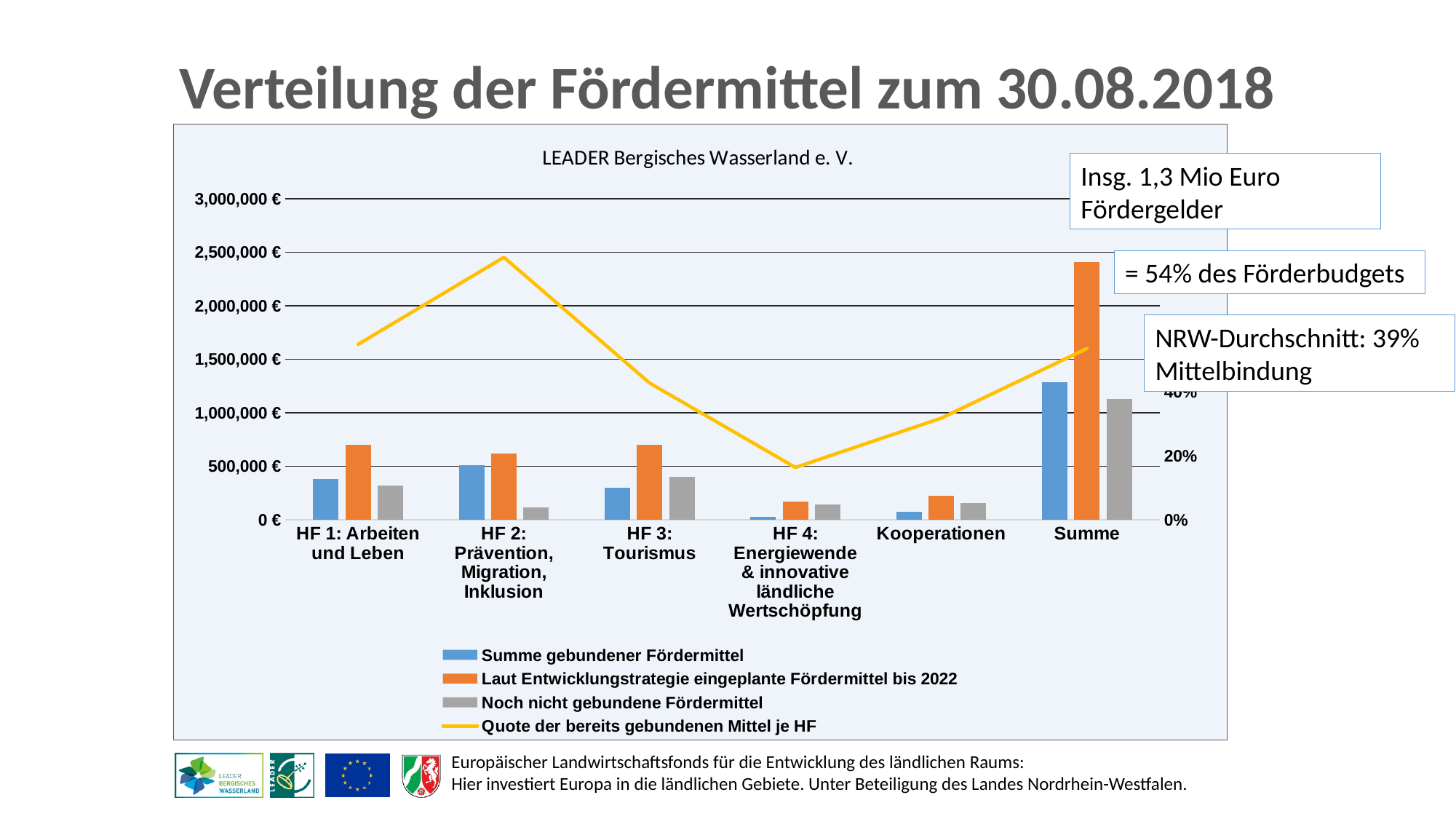
Which category has the highest bar for 'Laut Entwicklungstrategie eingeplante Fördermittel bis 2022'? Summe Is the value of 'Laut Entwicklungstrategie eingeplante Fördermittel bis 2022' for Summe greater or less than 2,000,000 €? greater What is the title of the chart? LEADER Bergisches Wasserland e. V. Which is larger for 'Summe gebundener Fördermittel': HF 1: Arbeiten und Leben or HF 2: Prävention, Migration, Inklusion? HF 2: Prävention, Migration, Inklusion Is the value of 'Summe gebundener Fördermittel' for Summe greater or less than 1,000,000 €? greater Which category has the lowest bar for 'Summe gebundener Fördermittel'? HF 4: Energiewende & innovative ländliche Wertschöpfung Is the value of 'Noch nicht gebundene Fördermittel' for HF 3: Tourismus greater or less than 500,000 €? less What kind of chart is shown on the slide? Bar chart combined with a line Which category has the highest point on the line 'Quote der bereits gebundenen Mittel je HF'? HF 2: Prävention, Migration, Inklusion Does the line 'Quote der bereits gebundenen Mittel je HF' rise or fall from HF 2 to HF 4? fall How many series does the chart legend list? 4 How many categories are shown on the x axis of the chart? 6